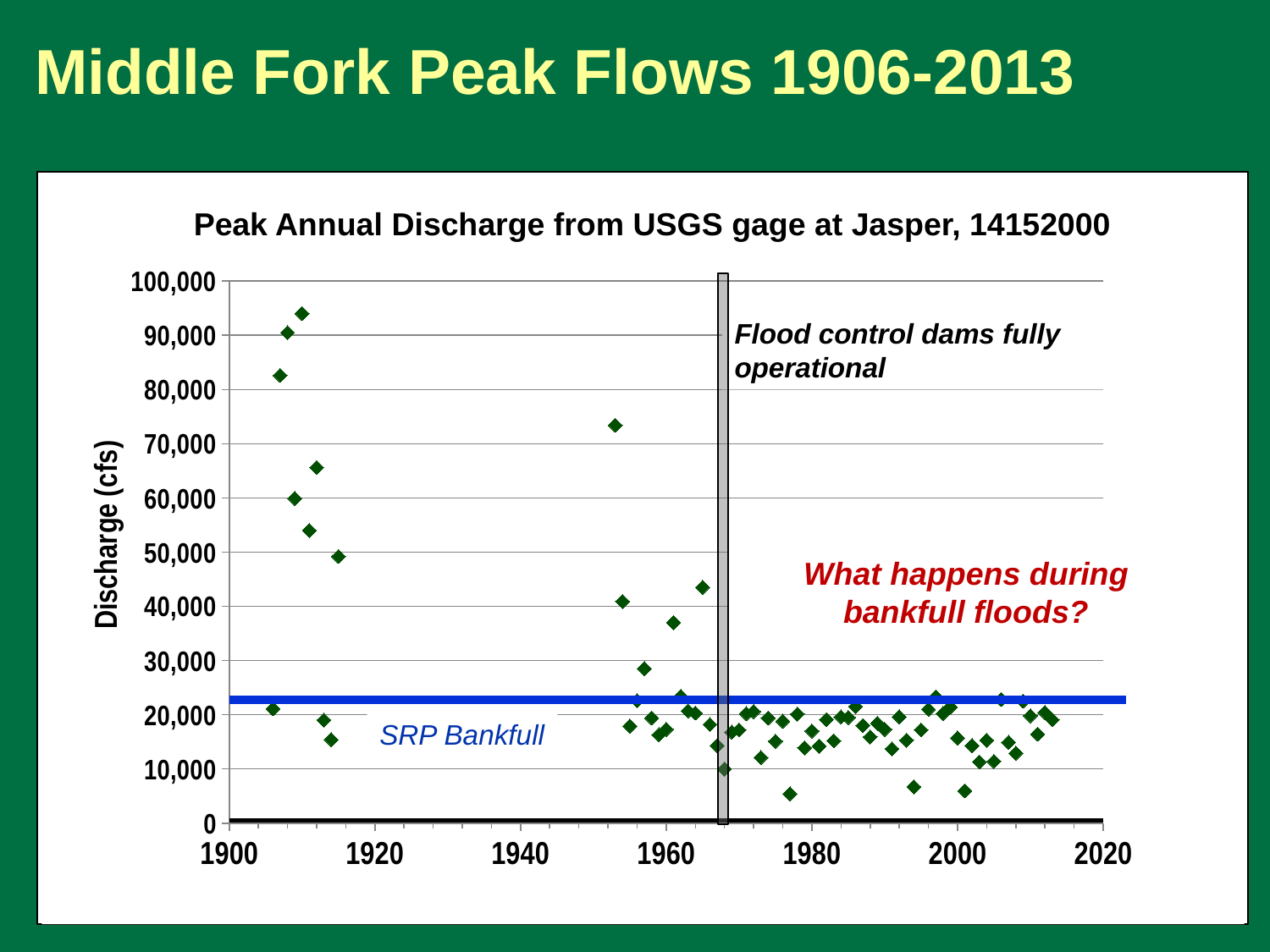
Is the lowest plotted peak discharge value greater or less than 10,000? less Is the peak discharge plotted around 1965 greater or less than 40,000? greater What kind of chart is shown on the slide? Scatter plot Overall, do the peak discharge values rise or fall from the early 1900s to the 2000s? Fall Is the peak discharge plotted around 1953 greater or less than 70,000? greater What is the label of the vertical axis? Discharge (cfs) What is the title of the chart? Peak Annual Discharge from USGS gage at Jasper, 14152000 Which period has the higher peak discharge values: before 1920 or after 1970? Before 1920 What is the highest value shown on the vertical axis? 100,000